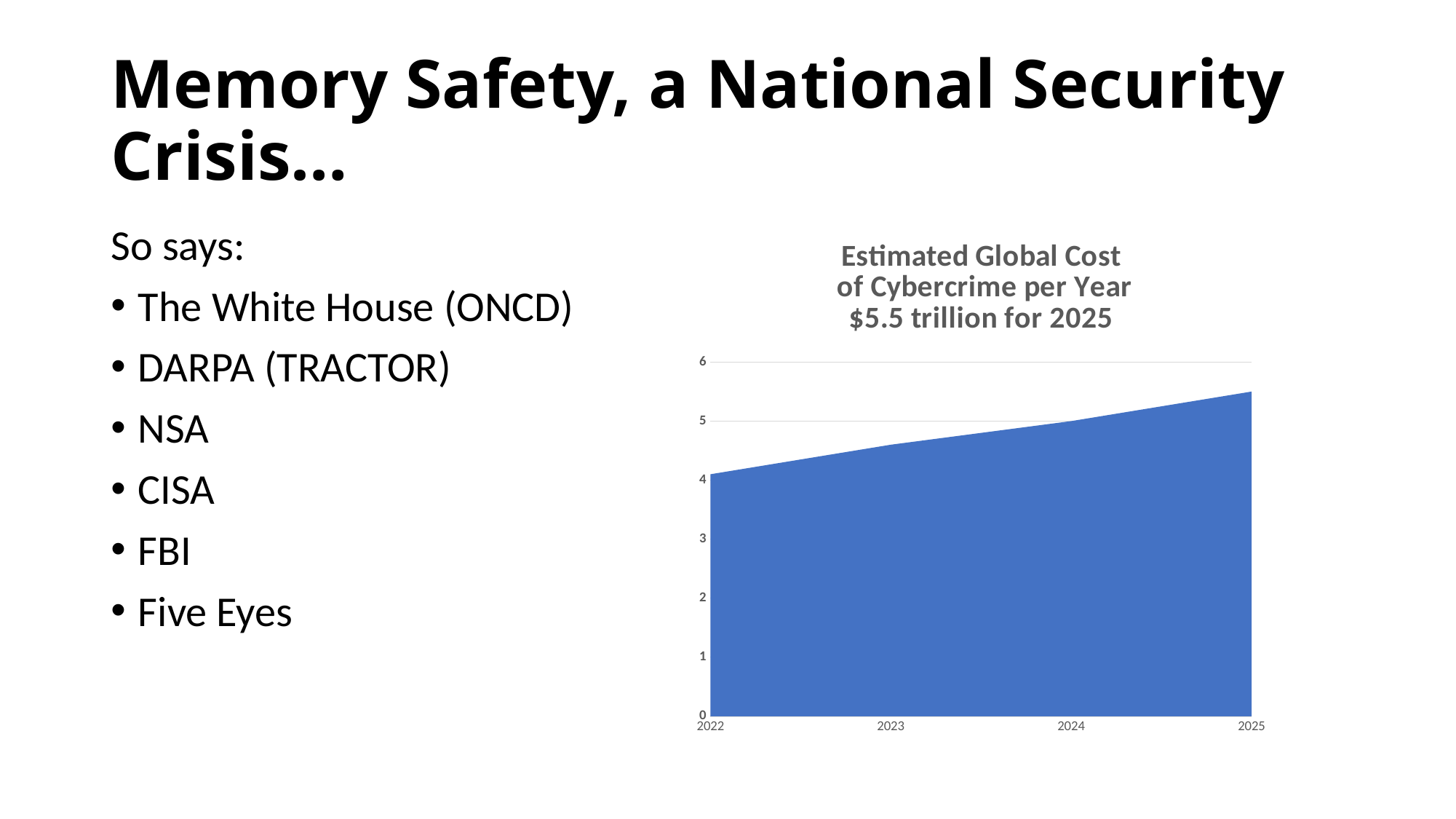
Which year has the lowest value in the chart? 2022 Is the value for 2025 greater or less than 5? greater What is the title of the chart? Estimated Global Cost of Cybercrime per Year $5.5 trillion for 2025 Do the values in the chart rise or fall from 2022 to 2025? rise Is the value for 2023 greater or less than 4? greater How many years are plotted along the x axis of the chart? 4 Which year has the highest value in the chart? 2025 What kind of chart is shown on the slide? area chart Which is larger, the value for 2024 or the value for 2022? 2024 What is the highest tick shown on the vertical axis of the chart? 6 Is the value for 2022 greater or less than 5? less According to the chart title, what is the estimated global cost of cybercrime for 2025? $5.5 trillion